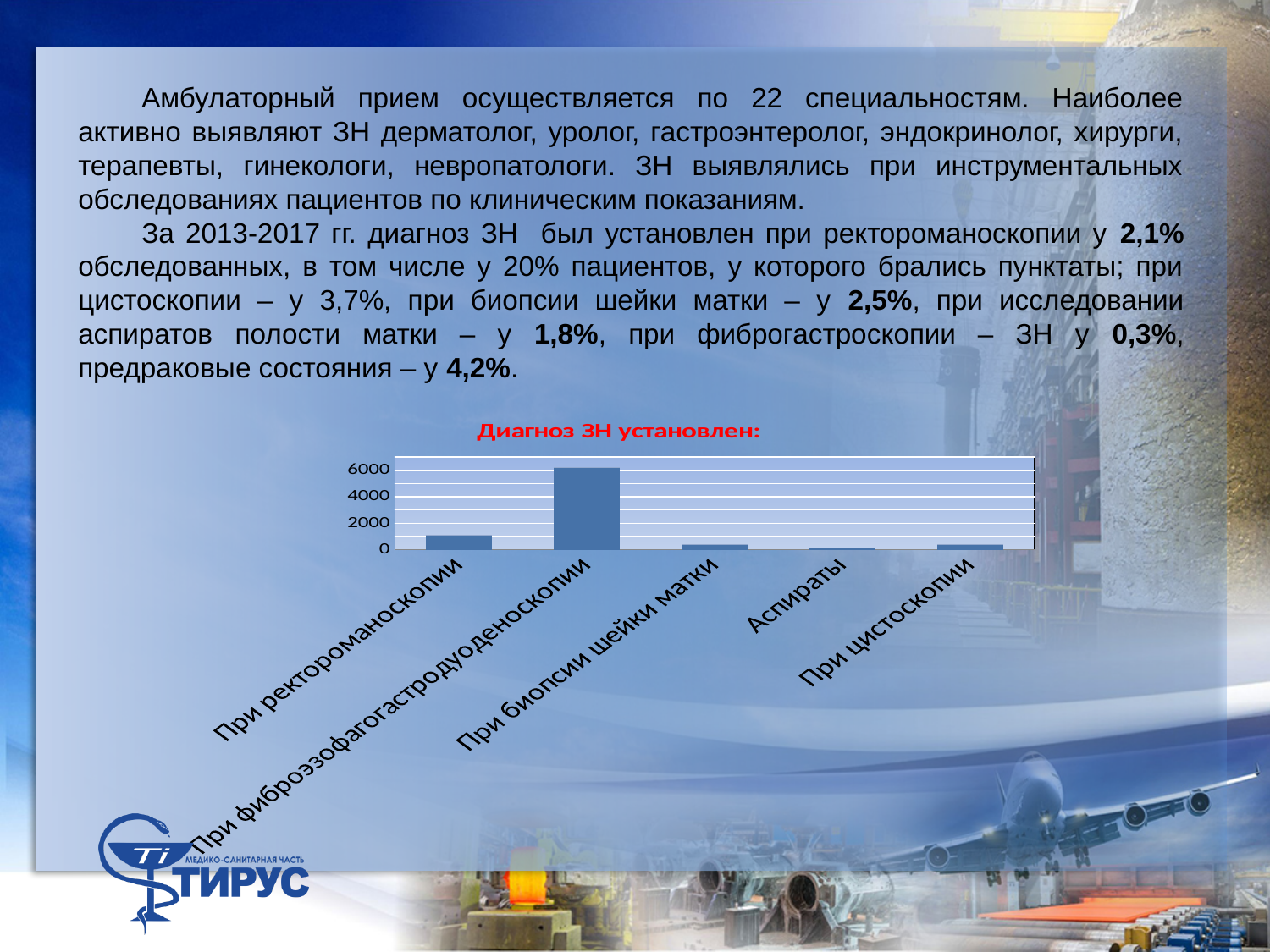
Which is larger, the value for При ректороманоскопии or the value for При биопсии шейки матки? При ректороманоскопии What is the highest tick value shown on the vertical axis of the chart? 6000 Is the value for При цистоскопии greater or less than 2000? less What kind of chart is shown on the slide? bar chart Which is larger, the value for При фиброэзофагогастродуоденоскопии or the value for Аспираты? При фиброэзофагогастродуоденоскопии Is the value for При ректороманоскопии greater or less than 2000? less Is the value for При биопсии шейки матки greater or less than 2000? less Which category has the highest value in the chart? При фиброэзофагогастродуоденоскопии What is the title of the chart? Диагноз ЗН установлен: How many categories are plotted in the chart? 5